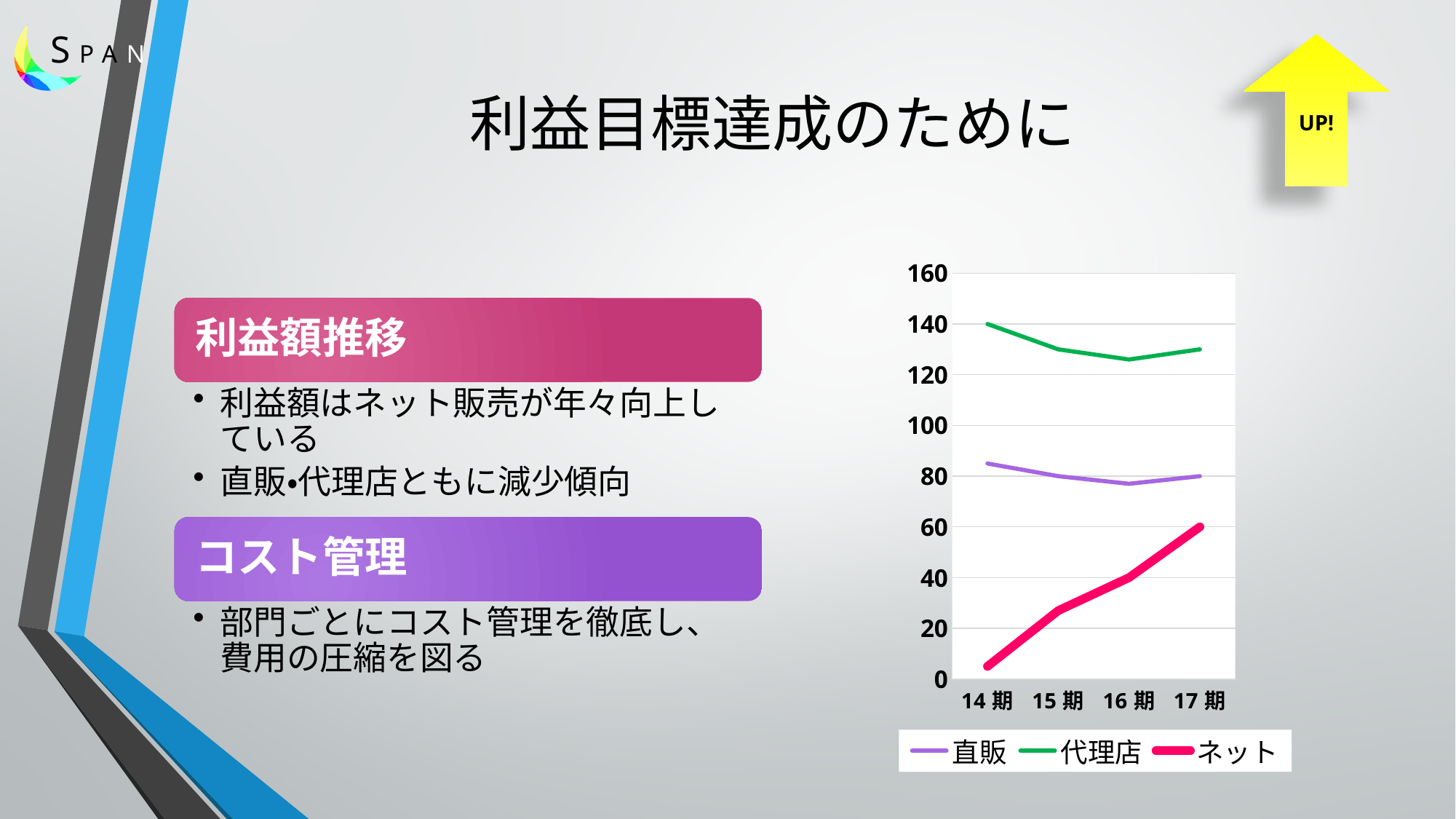
How many periods are shown on the x axis of the chart? 4 What is the value for 代理店 in 14期? 140 Which series has the highest value in 14期? 代理店 Which series has the lowest value in 17期? ネット Is the value for 代理店 in 16期 greater or less than 120? greater How many series does the chart legend list? 3 Is the value for 直販 in 14期 greater or less than 80? greater What is the value for ネット in 17期? 60 Is the value for ネット in 14期 greater or less than 20? less Do the values for ネット rise or fall from 14期 to 17期? rise What is the value for 直販 in 17期? 80 What kind of chart is shown on the slide? line chart